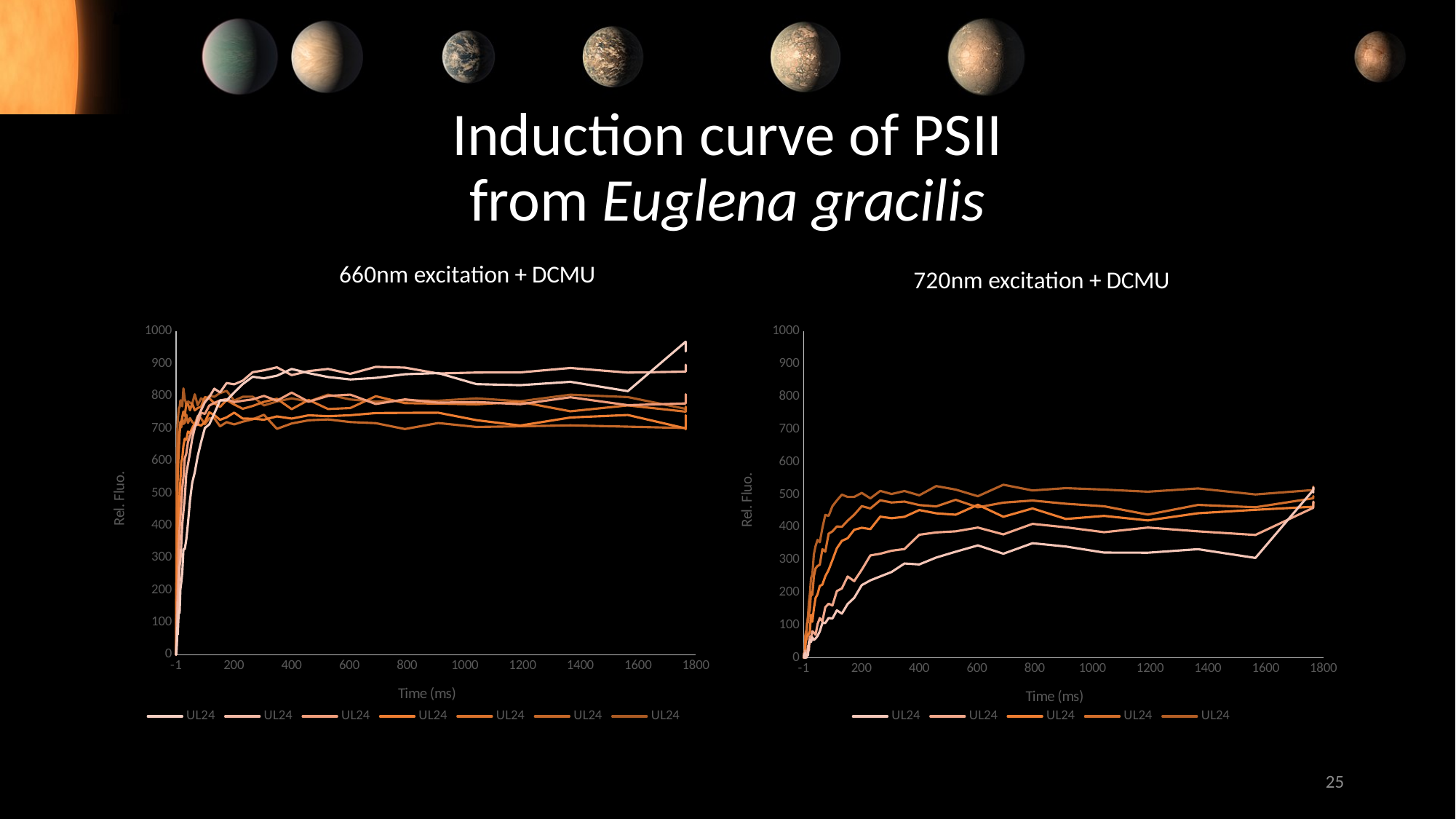
What kind of chart is the chart titled "720nm excitation + DCMU"? line chart In the chart titled "660nm excitation + DCMU", are the values of all curves at 1000 ms greater or less than 600? greater In the chart titled "660nm excitation + DCMU", is the value of the highest curve at 1600 ms greater or less than 800? greater What kind of chart is the chart titled "660nm excitation + DCMU"? line chart What is the label of the x axis on the chart titled "660nm excitation + DCMU"? Time (ms) In the chart titled "720nm excitation + DCMU", is the value of the lowest curve at 1400 ms greater or less than 400? less In the chart titled "720nm excitation + DCMU", do the curves generally rise or fall between 0 ms and 600 ms? rise What is the label of the y axis on the chart titled "720nm excitation + DCMU"? Rel. Fluo. How many series does the legend list for the chart titled "720nm excitation + DCMU"? 5 How many series does the legend list for the chart titled "660nm excitation + DCMU"? 7